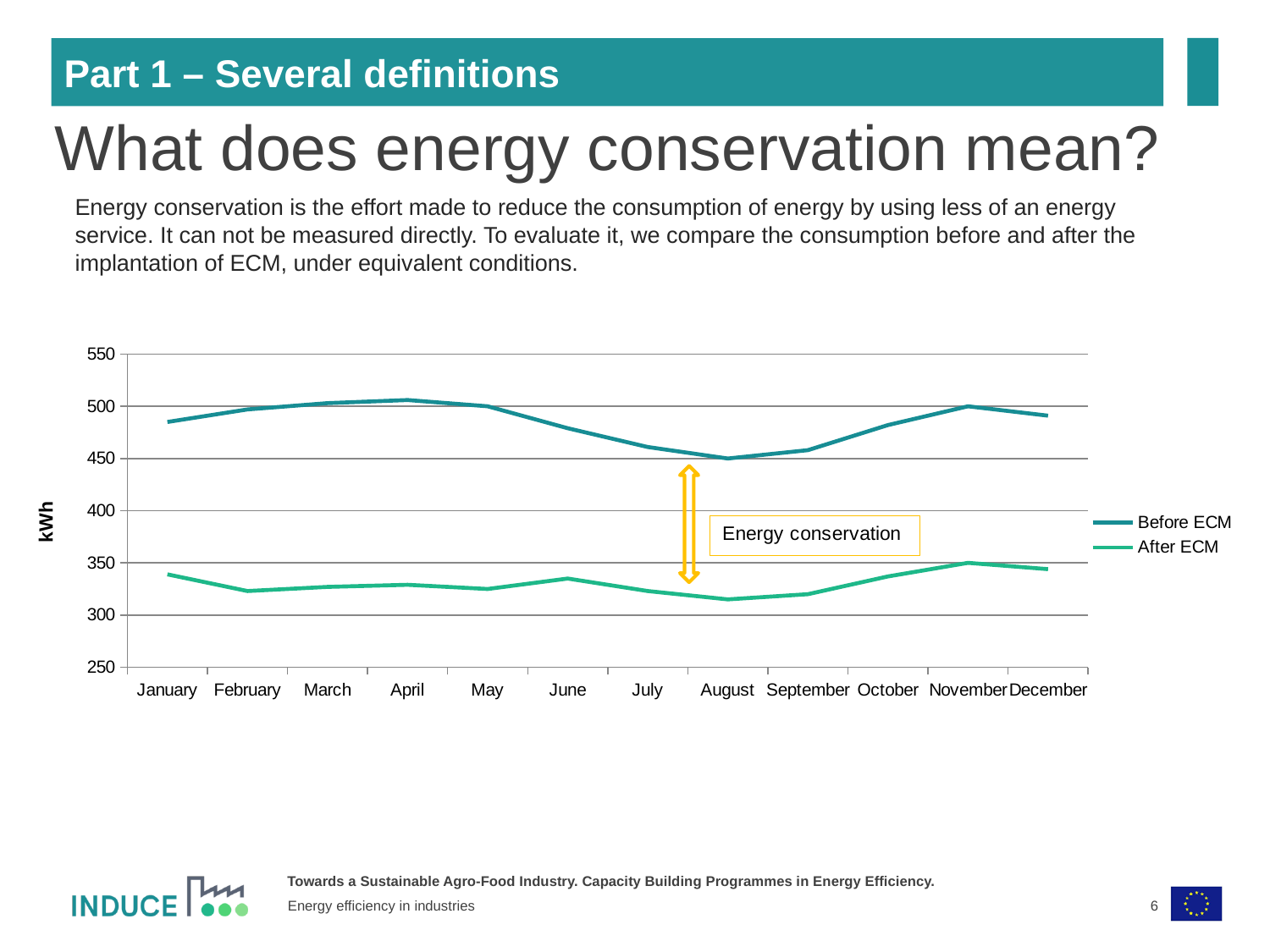
In which month is the Before ECM series at its lowest? August Does the Before ECM series rise or fall from April to August? fall Which series has the higher value in August, Before ECM or After ECM? Before ECM Is the value for After ECM in February greater or less than 350? less How many series does the legend list? 2 What kind of chart is shown on the slide? line chart Is the value for Before ECM in August greater or less than 500? less In which month is the After ECM series at its highest? November Is the value for Before ECM in January greater or less than 450? greater What unit is shown on the y axis label? kWh How many months are plotted along the x axis? 12